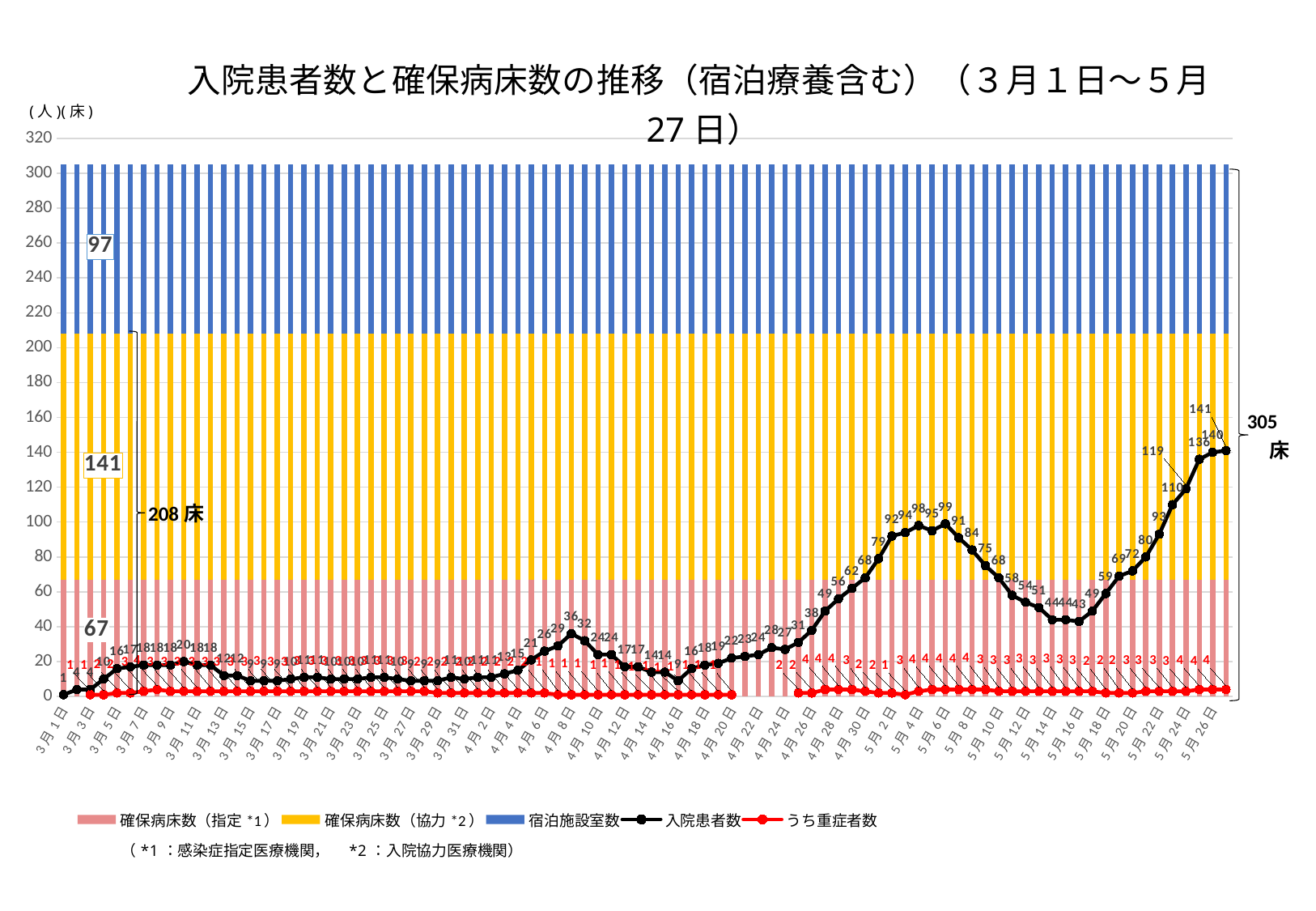
Which is larger, 確保病床数（協力）or 宿泊施設室数? 確保病床数（協力） How many series does the legend list? 5 What is the highest value reached by the うち重症者数 line? 4 What is the value of 確保病床数（協力*2）shown on the bars? 141 Does the 入院患者数 line rise or fall from 5月16日 to the end of the period? Rises What is the value of 確保病床数（指定*1）shown on the bars? 67 What is the difference between 確保病床数（協力）and 確保病床数（指定）? 74 What kind of chart is shown on the slide? A combined stacked bar and line chart What is the value of 宿泊施設室数 shown on the bars? 97 What is the total height of the stacked bar (all three bed/room series combined)? 305 床 What is the combined total of 確保病床数（指定）and 確保病床数（協力）as labelled on the chart? 208 床 What is the highest value reached by the 入院患者数 line? 141